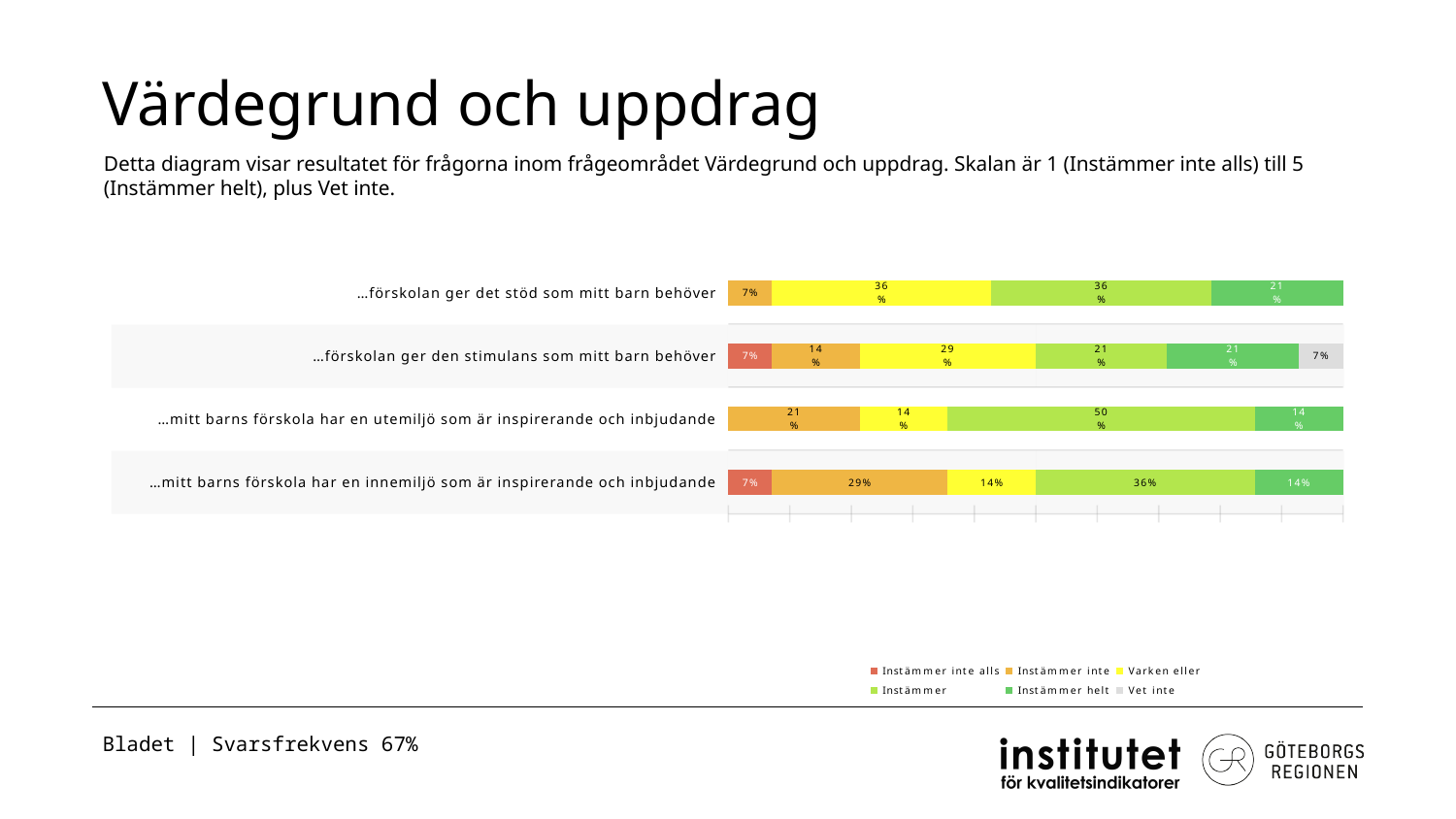
What is the difference between the 'Instämmer' share and the 'Instämmer helt' share for '…förskolan ger det stöd som mitt barn behöver'? 15% How many statements (categories) are plotted in the chart? 4 Which response category has the largest share for '…mitt barns förskola har en utemiljö som är inspirerande och inbjudande'? Instämmer How many series does the legend list? 6 What is the 'Instämmer' share for '…mitt barns förskola har en utemiljö som är inspirerande och inbjudande'? 50% Which is larger for '…mitt barns förskola har en innemiljö som är inspirerande och inbjudande': the 'Instämmer' share or the 'Instämmer inte' share? Instämmer What is the 'Instämmer inte' share for '…mitt barns förskola har en innemiljö som är inspirerande och inbjudande'? 29% What kind of chart is shown on the slide? Stacked bar chart What is the total of all labelled segments for '…förskolan ger den stimulans som mitt barn behöver'? 99% What is the 'Vet inte' share for '…förskolan ger den stimulans som mitt barn behöver'? 7% What is the 'Varken eller' share for '…förskolan ger det stöd som mitt barn behöver'? 36% Which legend entry is shown in yellow? Varken eller